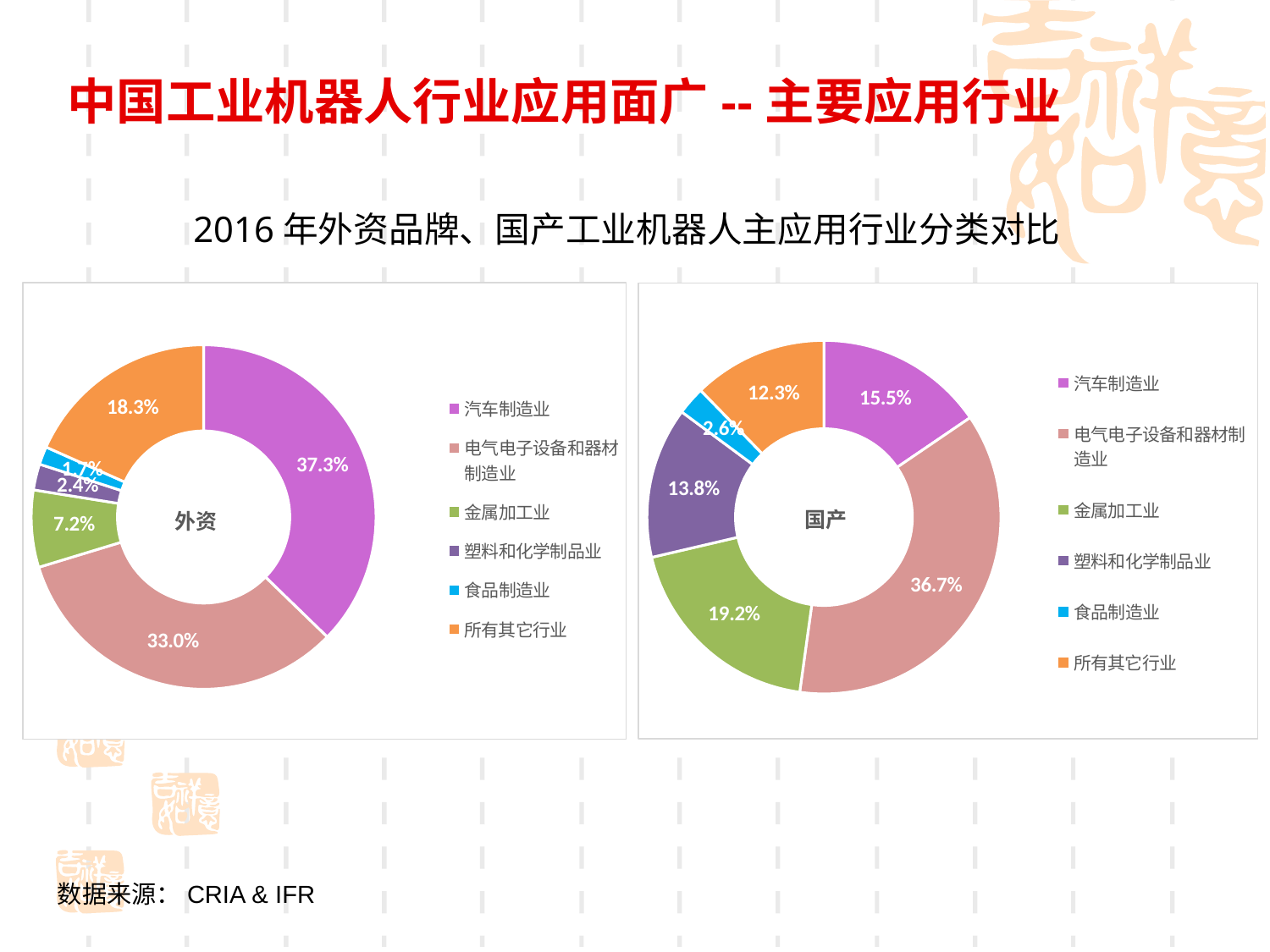
In the 外资 chart, which industry has the largest share? 汽车制造业 In the 国产 chart, what share does 电气电子设备和器材制造业 have? 36.7% In the 国产 chart, what is the difference between the shares of 金属加工业 and 塑料和化学制品业? 5.4% In the 国产 chart, which industry has the largest share? 电气电子设备和器材制造业 How many categories does the legend of the 国产 chart list? 6 What is the title shown above the two charts? 2016 年外资品牌、国产工业机器人主应用行业分类对比 In the 国产 chart, which industry has the smallest share? 食品制造业 Which chart shows a larger share for 汽车制造业, 外资 or 国产? 外资 In the 外资 chart, what share does 汽车制造业 have? 37.3% What kind of chart is the 外资 chart on the left? Pie (donut) chart In the 国产 chart, what share does 金属加工业 have? 19.2% In the 外资 chart, what share does 所有其它行业 have? 18.3%